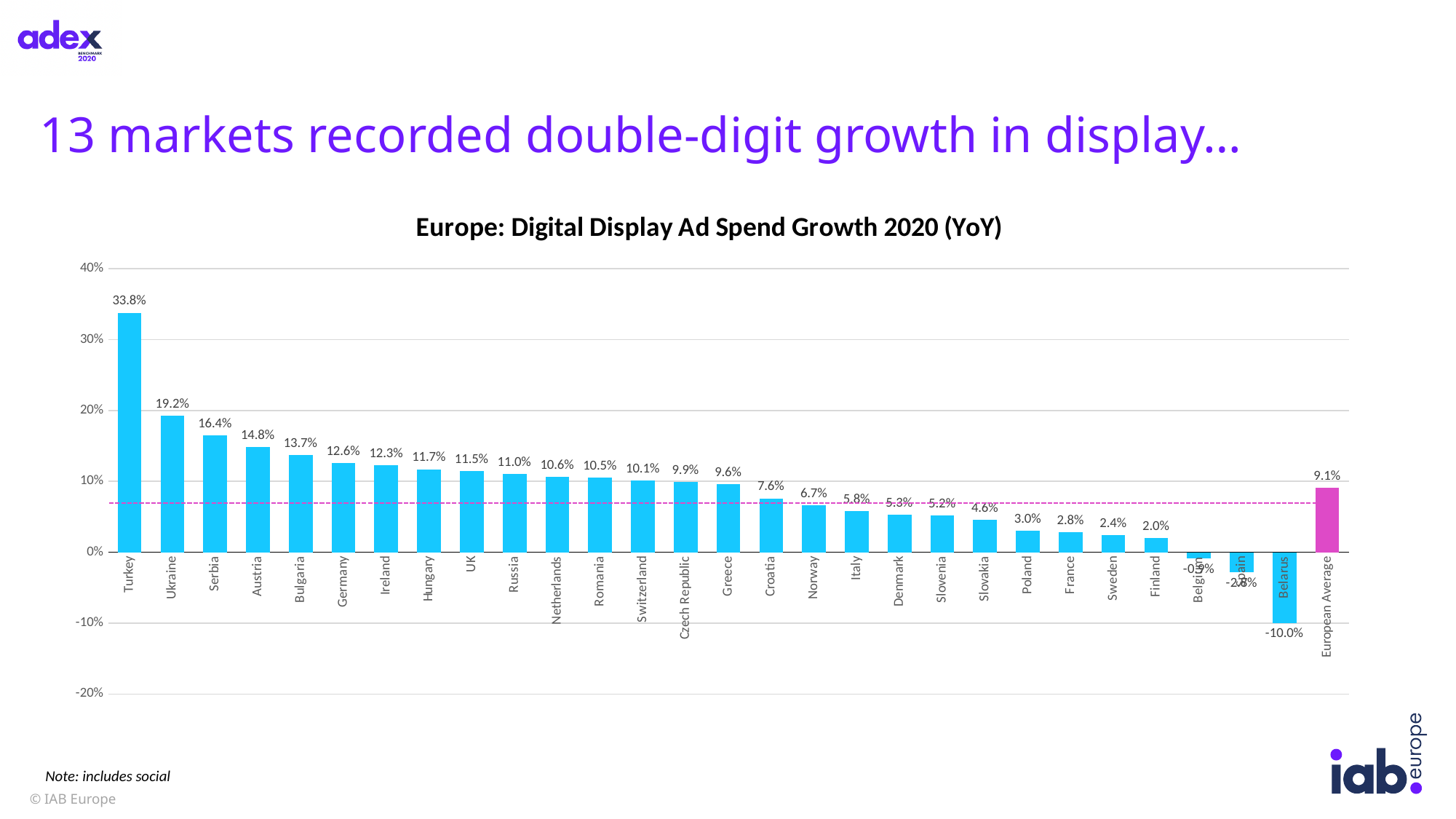
What is the value shown for the European Average bar? 9.1% Which market has the highest display ad spend growth in the chart? Turkey Which has the higher growth value, Germany or Ireland? Germany What is the value shown for the UK? 11.5% What is the difference between the growth values for Turkey and Ukraine? 14.6 percentage points What is the digital display ad spend growth value shown for Turkey? 33.8% What is the value shown for Belarus? -10.0% What is the title of the chart? Europe: Digital Display Ad Spend Growth 2020 (YoY) What kind of chart is shown on the slide? Bar chart How many bars are plotted in the chart, including the European Average? 29 Is the value for Croatia greater or less than 10%? less Which market has the lowest display ad spend growth in the chart? Belarus